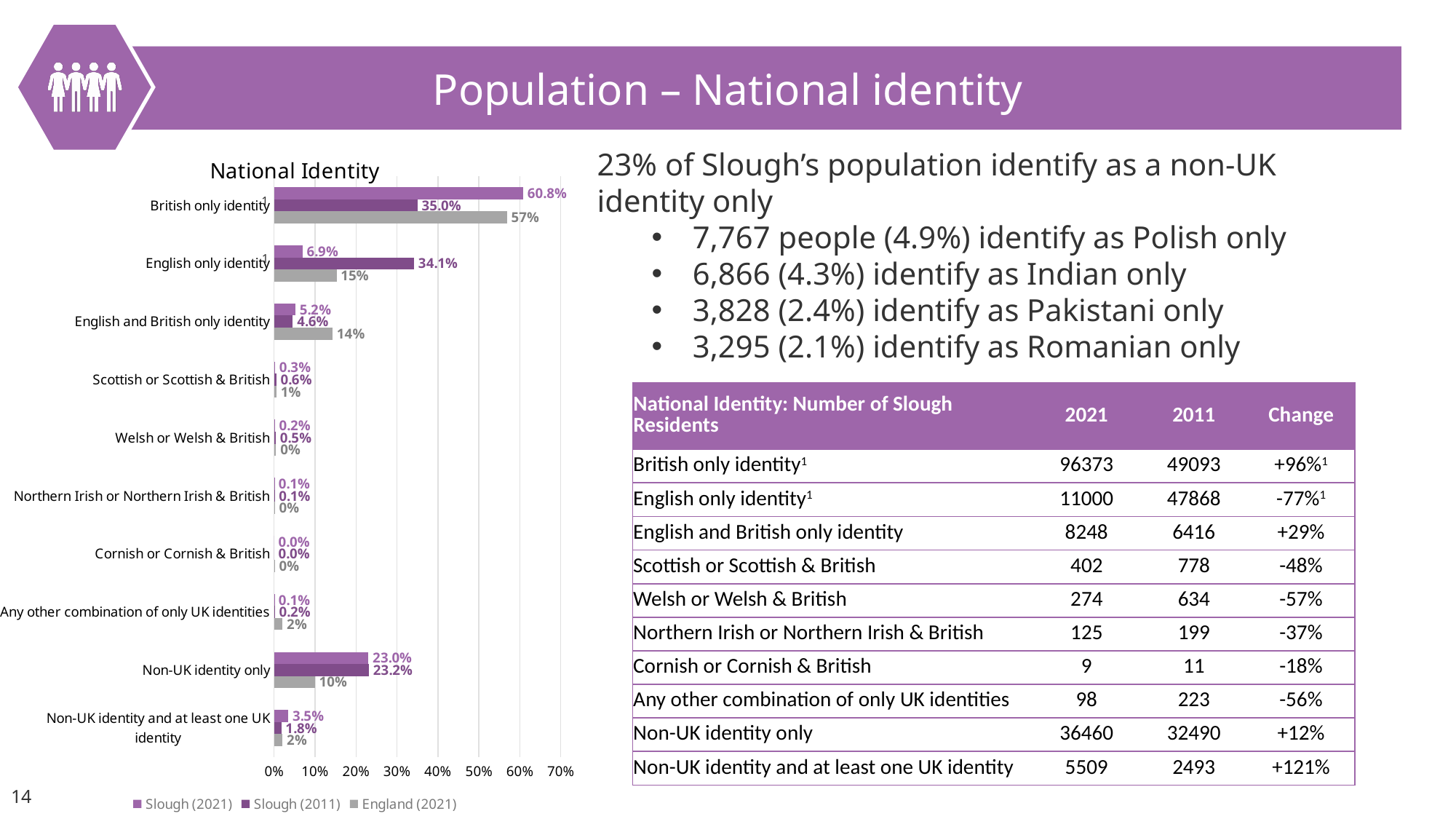
Which category has the highest Slough (2021) value in the National Identity chart? British only identity What is the Slough (2011) value for English only identity in the National Identity chart? 34.1% What is the Slough (2021) value for British only identity in the National Identity chart? 60.8% Which is larger for English only identity: the Slough (2021) value or the England (2021) value? England (2021) Which category has the lowest England (2021) value among British only identity, English only identity and English and British only identity? English and British only identity Is the England (2021) value for British only identity greater or less than 50%? greater What are the three series listed in the legend of the National Identity chart? Slough (2021), Slough (2011), England (2021) What kind of chart is the National Identity chart? Bar chart How many categories are shown on the y axis of the National Identity chart? 10 What is the England (2021) value for Non-UK identity only in the National Identity chart? 10% What is the difference between the Slough (2021) and Slough (2011) values for British only identity? 25.8% How many series does the legend of the National Identity chart list? 3